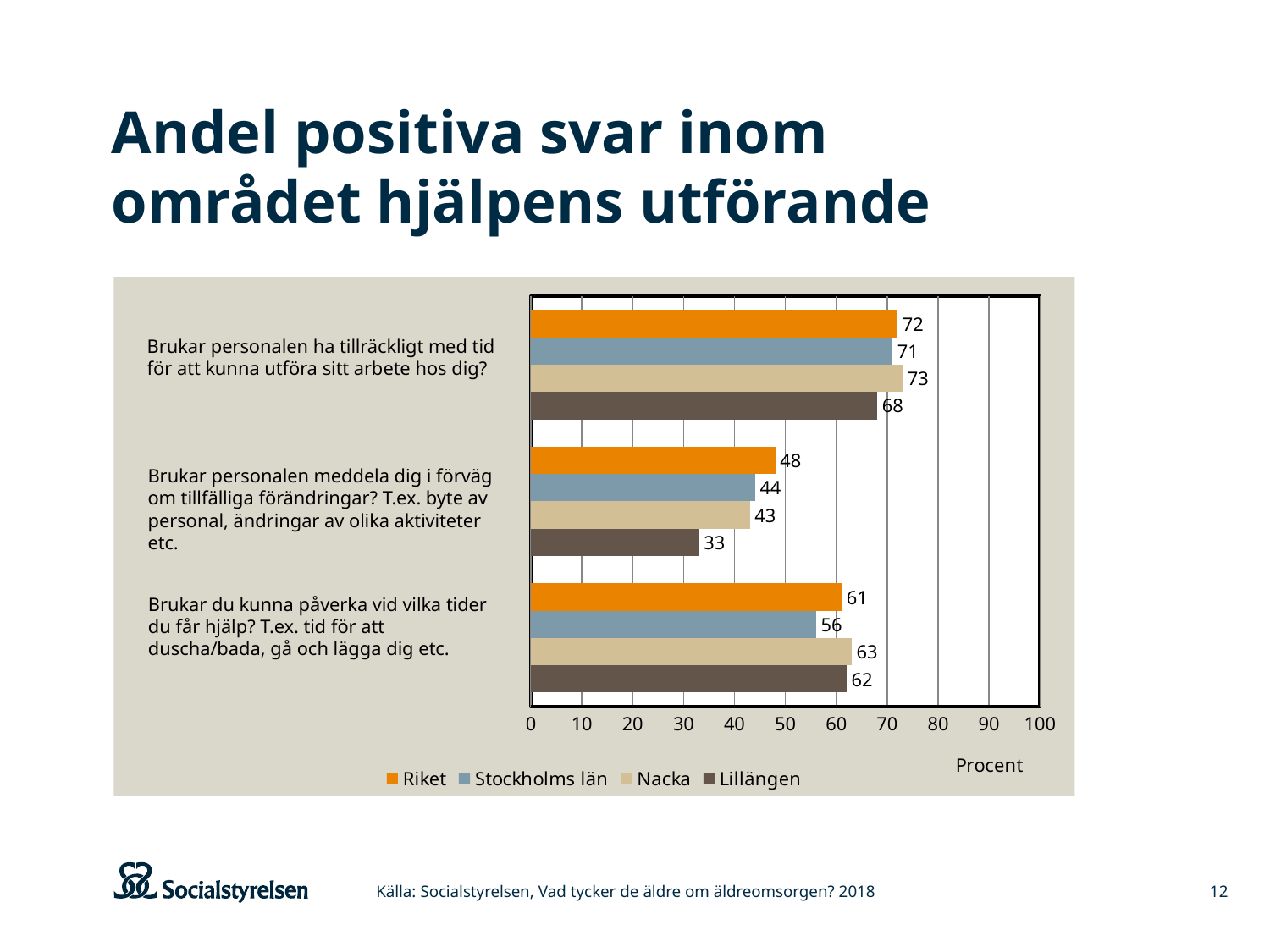
How many series does the legend list? 4 Is the value for Lillängen on the question "Brukar personalen ha tillräckligt med tid för att kunna utföra sitt arbete hos dig?" greater or less than 60? greater What kind of chart is shown on the slide? Bar chart Which series has the highest value on the question "Brukar personalen ha tillräckligt med tid för att kunna utföra sitt arbete hos dig?" Nacka What is the difference between Riket and Lillängen on the question "Brukar personalen meddela dig i förväg om tillfälliga förändringar?" 15 What is the value for Stockholms län on the question "Brukar du kunna påverka vid vilka tider du får hjälp?" 56 What unit is shown on the horizontal axis of the chart? Procent Which series has the lowest value on the question "Brukar personalen meddela dig i förväg om tillfälliga förändringar?" Lillängen Which is larger on the question "Brukar du kunna påverka vid vilka tider du får hjälp?": Riket or Nacka? Nacka What is the value for Nacka on the question "Brukar personalen ha tillräckligt med tid för att kunna utföra sitt arbete hos dig?" 73 What is the value for Lillängen on the question "Brukar personalen meddela dig i förväg om tillfälliga förändringar?" 33 How many questions (categories) are shown on the chart? 3